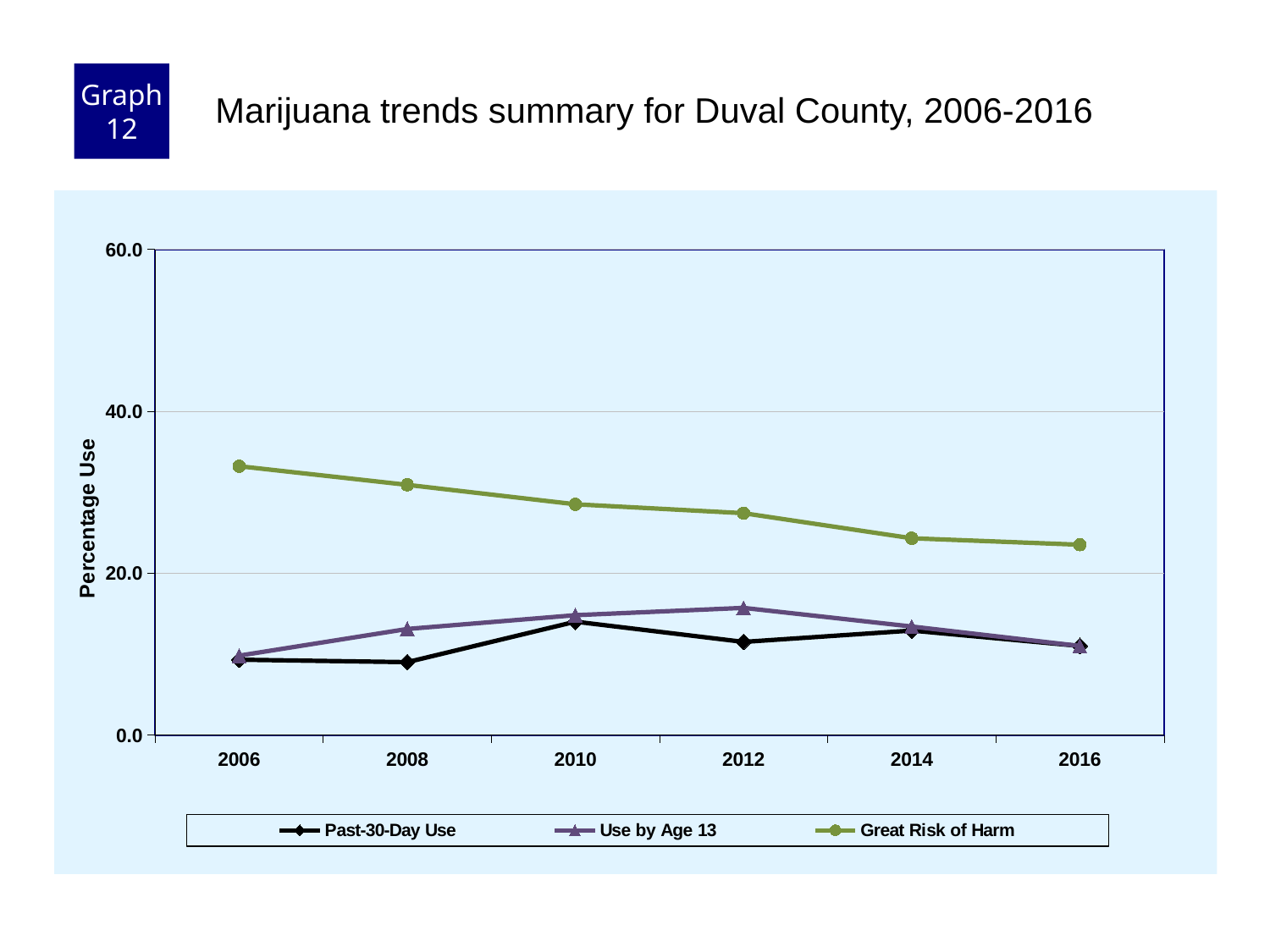
In which year is the Great Risk of Harm value highest? 2006 Does the Great Risk of Harm line rise or fall from 2006 to 2016? fall Is the Great Risk of Harm value for 2006 greater or less than 20.0? greater What kind of chart is shown on the slide? line chart What is the title of the chart? Marijuana trends summary for Duval County, 2006-2016 How many years are plotted along the x axis? 6 Is the Great Risk of Harm value for 2006 greater or less than 40.0? less How many series does the legend list? 3 In which year is the Great Risk of Harm value lowest? 2016 In 2006, which is larger: Great Risk of Harm or Past-30-Day Use? Great Risk of Harm Is the Past-30-Day Use value for 2008 greater or less than 20.0? less What is the label on the y axis? Percentage Use